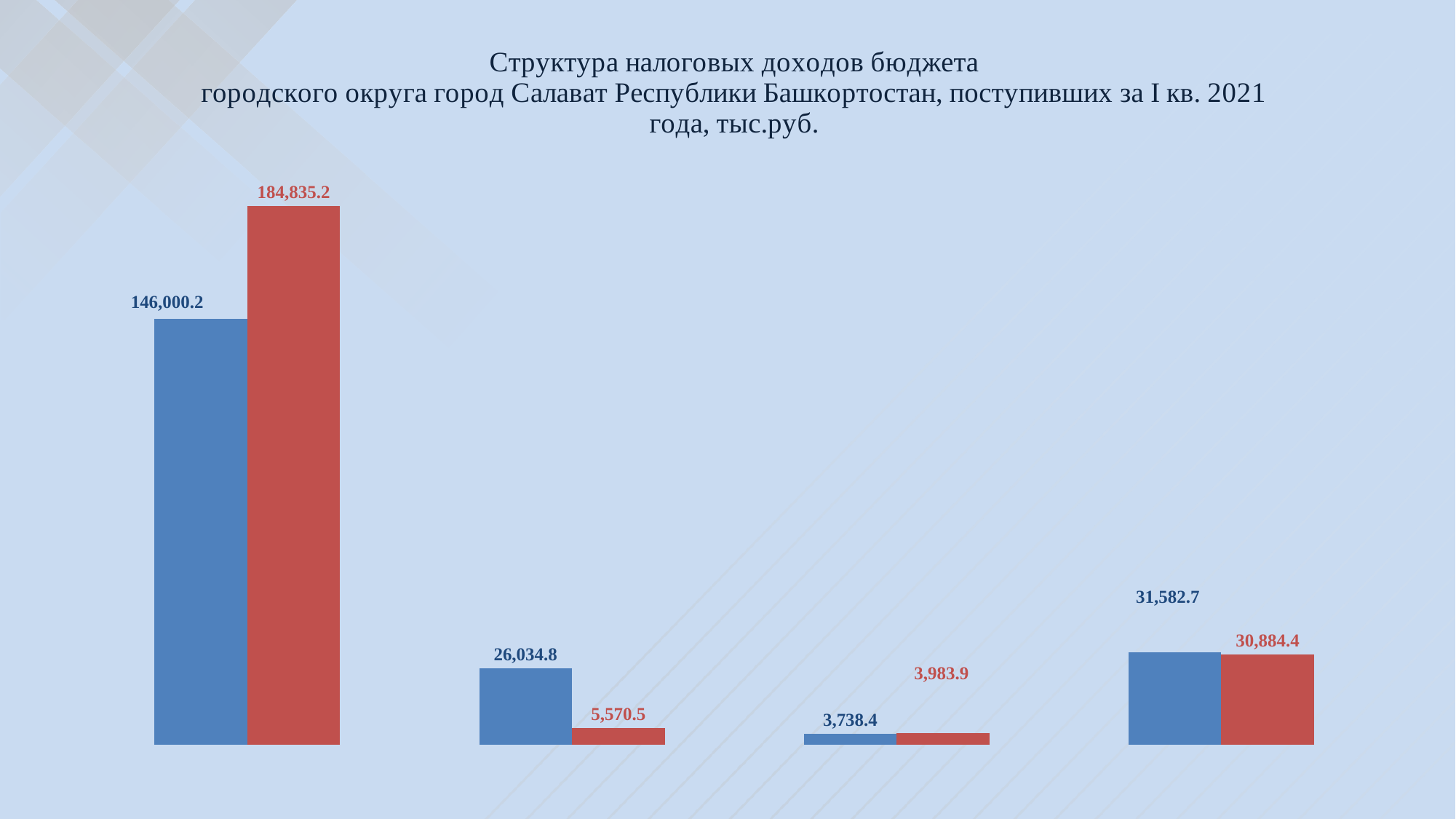
What is the value of the red bar in the first (leftmost) group? 184,835.2 What is the value of the blue bar in the fourth (rightmost) group? 31,582.7 What unit of measurement is stated in the chart title? тыс.руб. What is the value of the blue bar in the second group from the left? 26,034.8 What is the difference between the red and blue bars in the first (leftmost) group? 38,835.0 Which bar has the highest value on the chart? the red bar in the first group (184,835.2) Which bar has the lowest value on the chart? the blue bar in the third group (3,738.4) How many groups of bars does the chart show? 4 What is the value of the blue bar in the first (leftmost) group? 146,000.2 What kind of chart is shown on the slide? bar chart What is the value of the red bar in the third group from the left? 3,983.9 In the second group from the left, which bar is larger, the blue or the red? blue